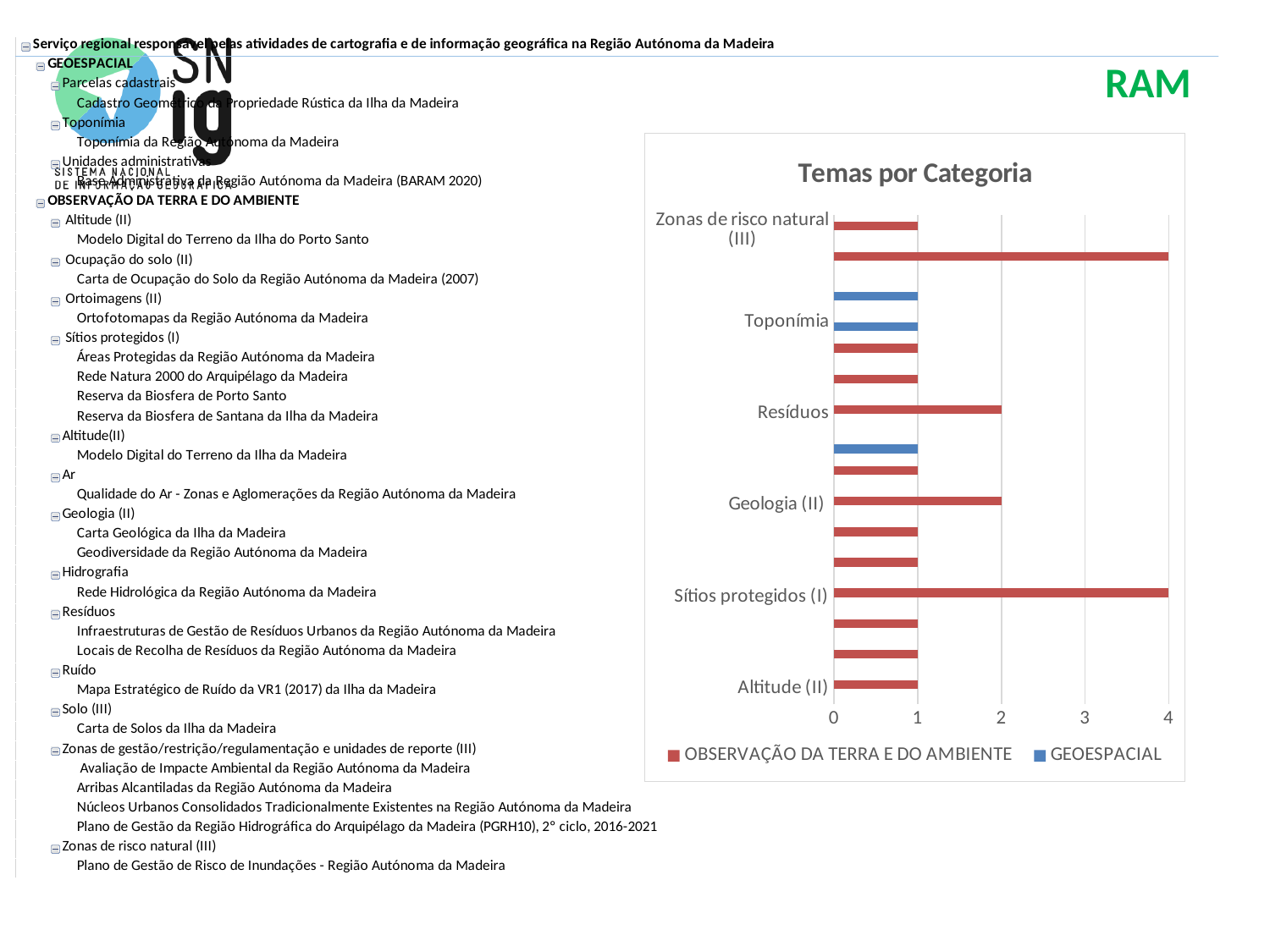
In the 'Temas por Categoria' chart, what is the value for Toponímia? 1 In the 'Temas por Categoria' chart, what is the difference between the values for Sítios protegidos (I) and Geologia (II)? 2 In the 'Temas por Categoria' chart, what is the value for Sítios protegidos (I)? 4 In the 'Temas por Categoria' chart, which series does the Toponímia bar belong to? GEOESPACIAL In the 'Temas por Categoria' chart, what is the value for Resíduos? 2 What type of chart is 'Temas por Categoria'? bar chart How many series does the legend of the 'Temas por Categoria' chart list? 2 In the 'Temas por Categoria' chart, what is the value for Altitude (II)? 1 In the 'Temas por Categoria' chart, which is larger, the value for Sítios protegidos (I) or the value for Resíduos? Sítios protegidos (I) In the 'Temas por Categoria' chart, what is the value for Geologia (II)? 2 In the 'Temas por Categoria' chart, is the value for Sítios protegidos (I) greater or less than 3? greater In the 'Temas por Categoria' chart, which series is shown in blue? GEOESPACIAL